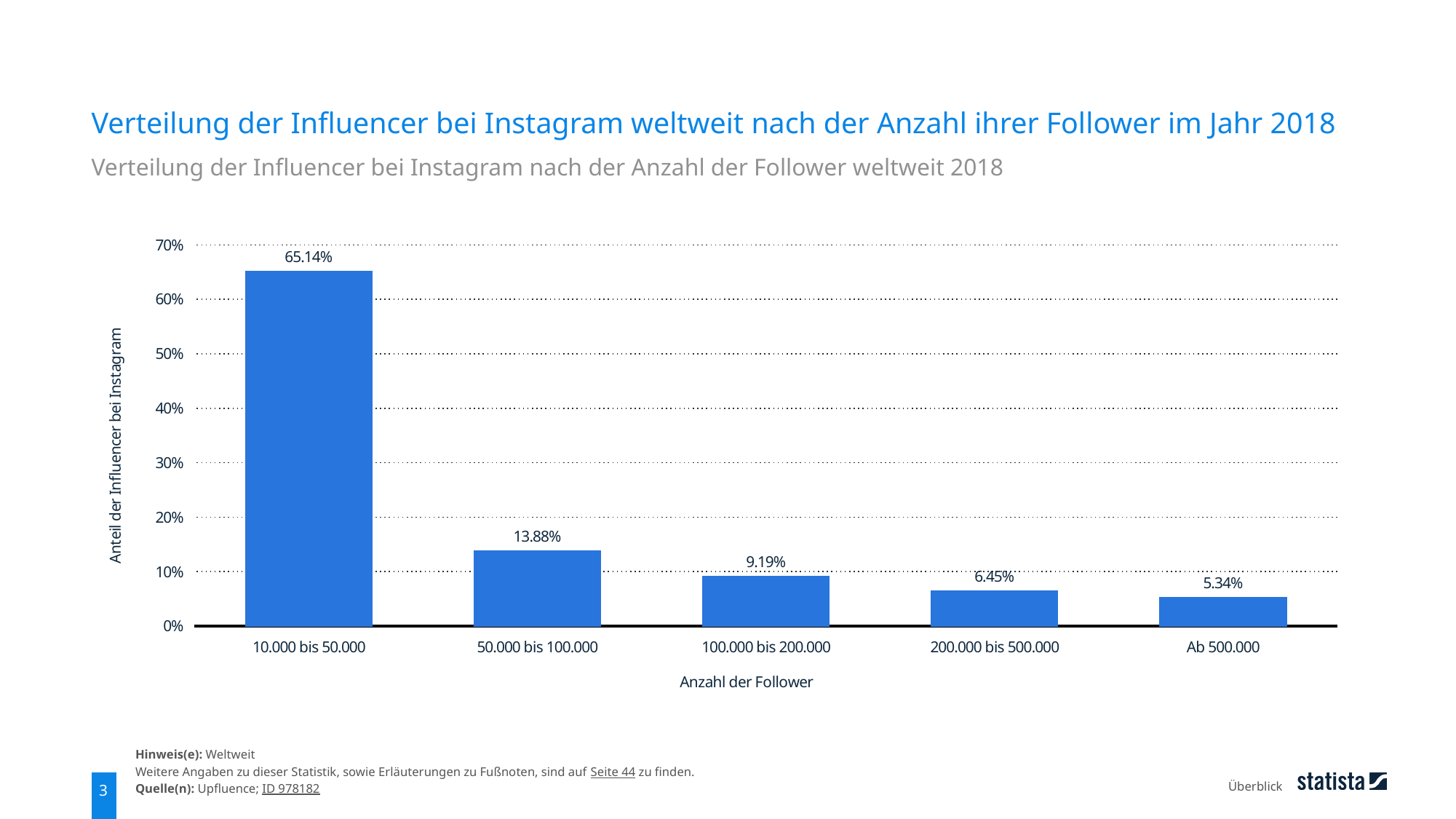
Which follower category has the lowest share of influencers? Ab 500.000 What kind of chart is shown on the slide? Bar chart What is the value shown for the 50.000 bis 100.000 follower category? 13.88% What is the label of the y axis? Anteil der Influencer bei Instagram How many follower categories are shown on the x axis? 5 What share of influencers fall into the Ab 500.000 follower category? 5.34% Which follower category has the highest share of influencers? 10.000 bis 50.000 What is the difference between the shares for 100.000 bis 200.000 and 200.000 bis 500.000 followers? 2.74% Do the values rise or fall as the follower categories increase along the x axis? Fall What share of Instagram influencers have 10.000 bis 50.000 followers? 65.14% Which category has a larger share: 50.000 bis 100.000 or 100.000 bis 200.000? 50.000 bis 100.000 Is the value for 200.000 bis 500.000 followers greater or less than 10%? less